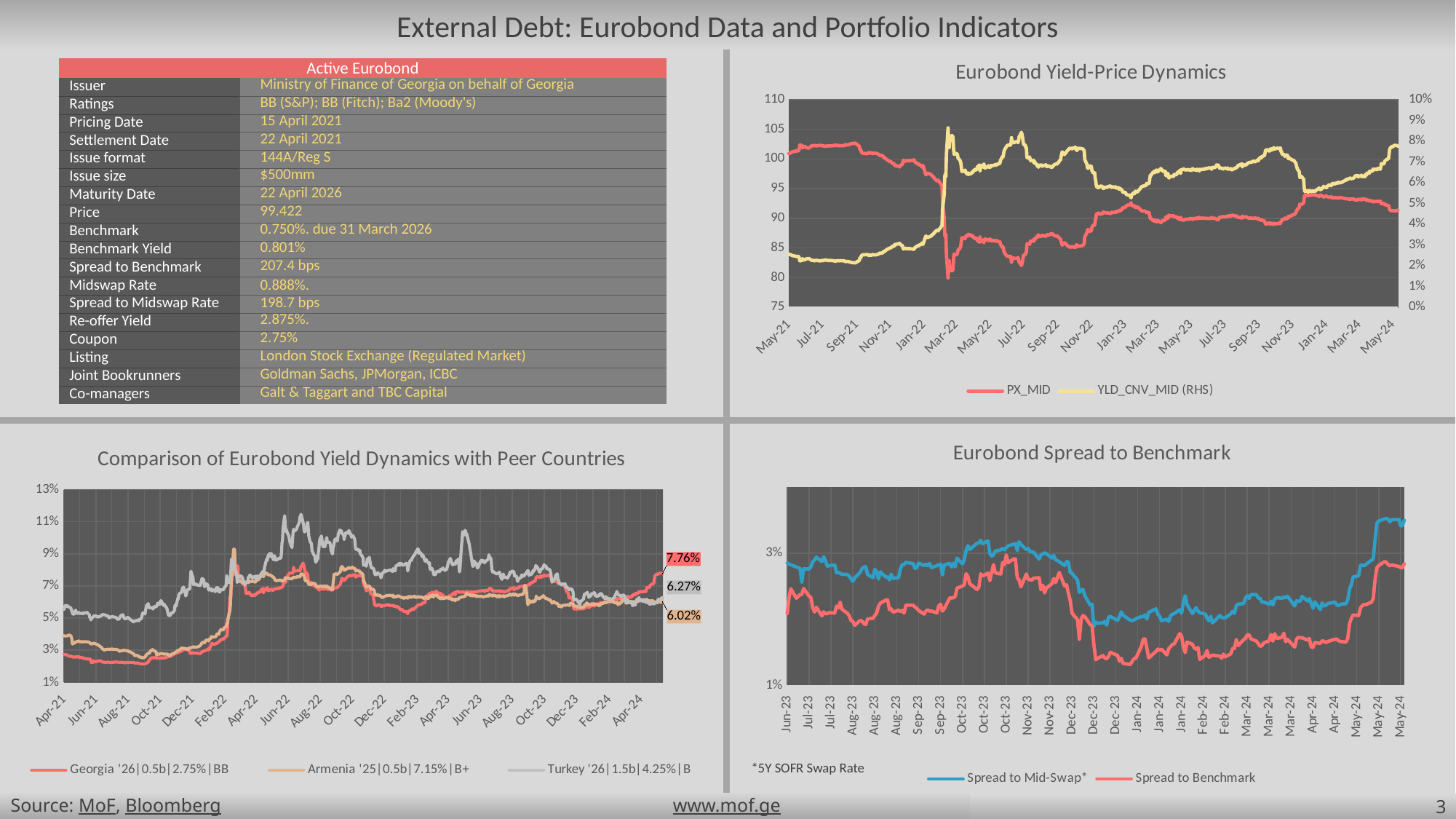
How many series does the legend of the 'Comparison of Eurobond Yield Dynamics with Peer Countries' chart list? 3 On the 'Eurobond Spread to Benchmark' chart, is the Spread to Mid-Swap value at May-24 greater or less than 3%? greater On the 'Comparison of Eurobond Yield Dynamics with Peer Countries' chart, what is the latest yield value labelled for Georgia? 7.76% On the 'Comparison of Eurobond Yield Dynamics with Peer Countries' chart, what is the latest yield value labelled for Turkey? 6.27% On the 'Comparison of Eurobond Yield Dynamics with Peer Countries' chart, what is the difference between the labelled latest yields of Georgia and Armenia? 1.74 percentage points On the 'Eurobond Spread to Benchmark' chart, which series is higher at May-24: Spread to Mid-Swap or Spread to Benchmark? Spread to Mid-Swap On the 'Eurobond Yield-Price Dynamics' chart, is the PX_MID value at May-24 greater or less than 95? less On the 'Eurobond Spread to Benchmark' chart, what does the footnote say the asterisk on 'Spread to Mid-Swap*' refers to? 5Y SOFR Swap Rate On the 'Comparison of Eurobond Yield Dynamics with Peer Countries' chart, what is the latest yield value labelled for Armenia? 6.02% On the 'Eurobond Yield-Price Dynamics' chart, does the PX_MID series overall rise or fall from May-21 to May-24? fall What kind of chart is the 'Eurobond Yield-Price Dynamics' chart? Line chart On the 'Comparison of Eurobond Yield Dynamics with Peer Countries' chart, which country has the highest labelled latest yield? Georgia